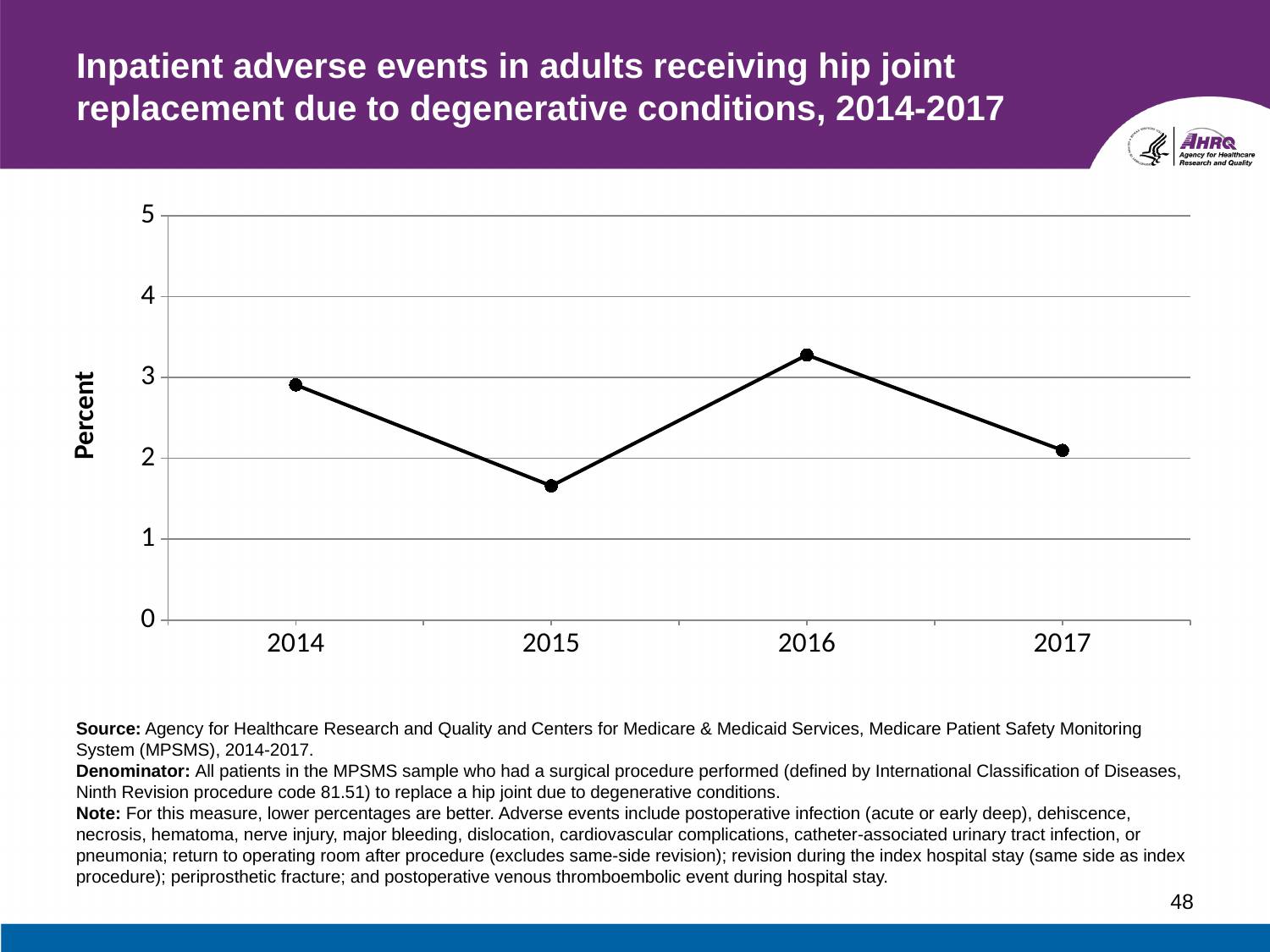
Which year has the highest percentage of inpatient adverse events? 2016 Which year has a higher value, 2014 or 2015? 2014 Which year has a higher value, 2016 or 2017? 2016 Which year has the lowest percentage of inpatient adverse events? 2015 What kind of chart is shown on the slide? line chart Is the value for 2014 greater or less than 2? greater How many years are plotted on the x axis? 4 Does the value rise or fall from 2016 to 2017? fall Is the value for 2015 greater or less than 2? less Is the value for 2017 greater or less than 3? less What is the label on the y axis? Percent